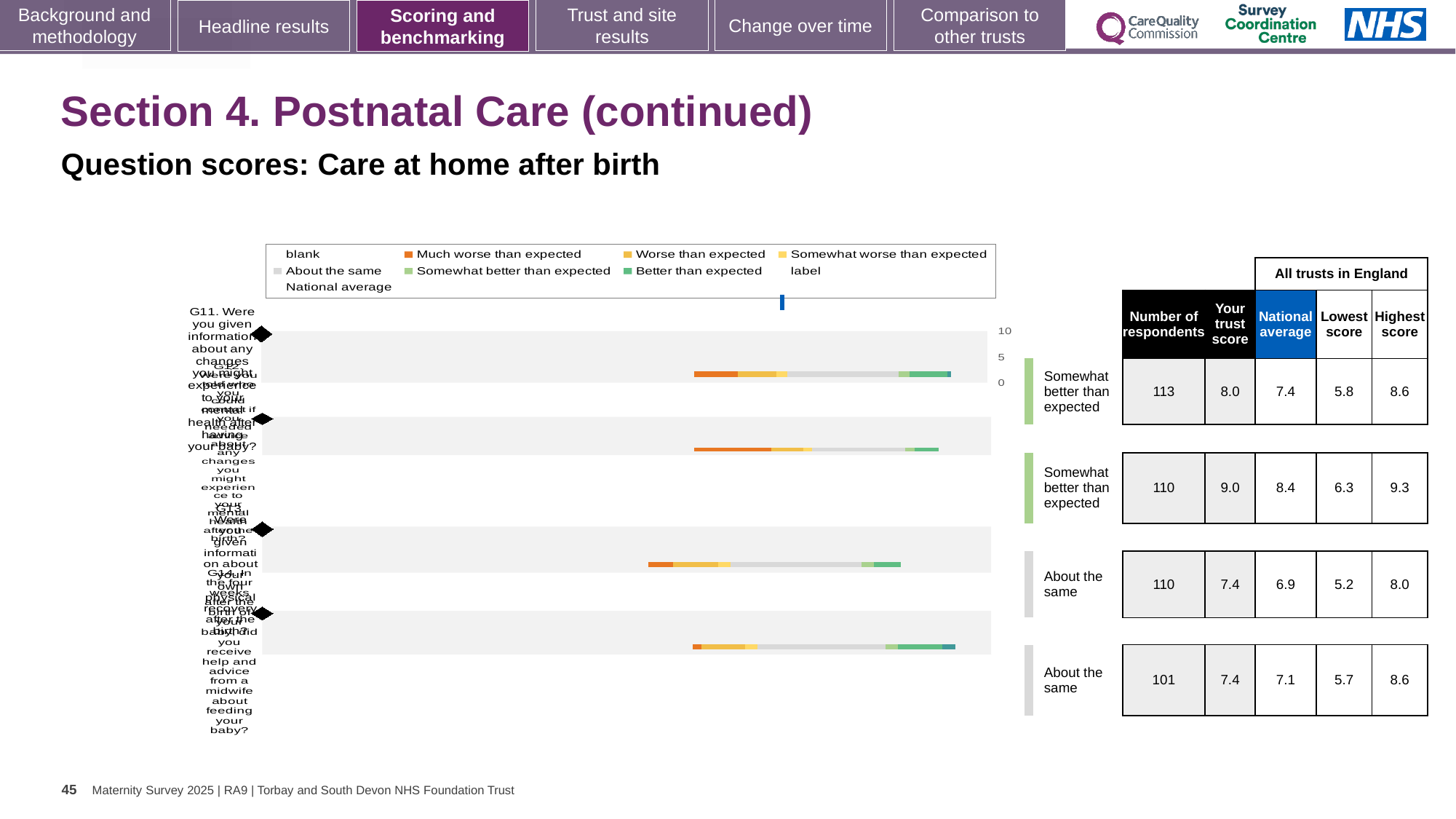
How many entries does the chart legend list? 9 What kind of chart is shown on the slide? bar chart Which is larger, the national average for the first bar or for the second bar? the second bar (8.4) What is the difference between the trust scores of the second and first question bars? 1.0 Which legend entry is shown in orange? Much worse than expected What is the trust score for the second question bar? 9.0 What is the highest value shown on the chart's axis? 10 Which question bar has the highest trust score? the second bar (9.0) What is the trust score for the first (top) question bar, G11? 8.0 What is the number of respondents for the fourth (bottom) question bar? 101 How many question bars are plotted in the chart? 4 What is the national average for the third question bar? 6.9